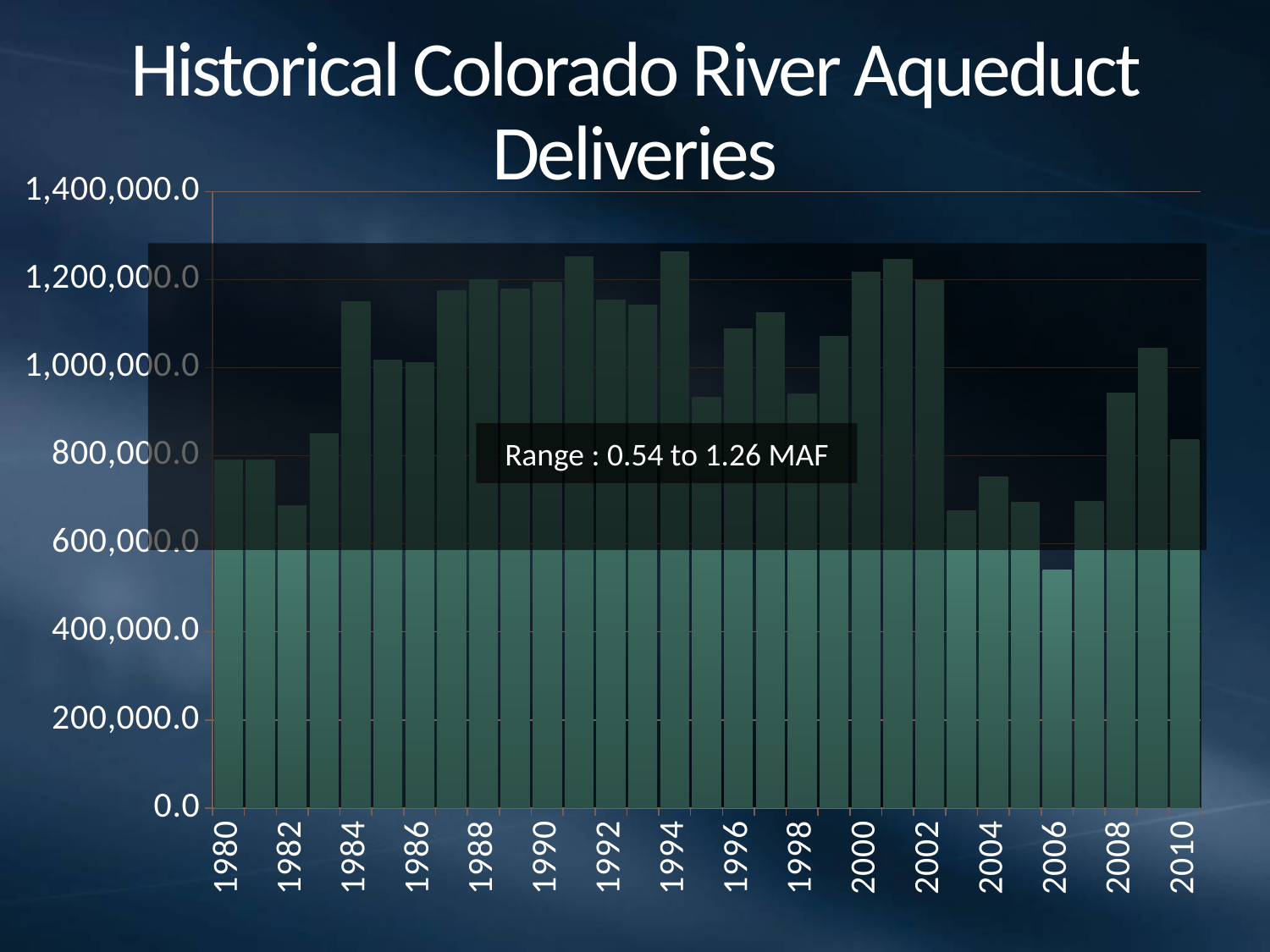
Which year has the larger value, 1984 or 1986? 1984 Which year has the larger value, 2006 or 2008? 2008 What is the title of the chart? Historical Colorado River Aqueduct Deliveries Is the value for 2004 greater or less than 800,000.0? less Is the value for 2006 greater or less than 600,000.0? less Which year has the lowest delivery value? 2006 Is the value for 1984 greater or less than 1,000,000.0? greater What range of deliveries does the text box on the chart state? 0.54 to 1.26 MAF What kind of chart is shown on the slide? bar chart Do the values rise or fall from 2002 to 2006? fall